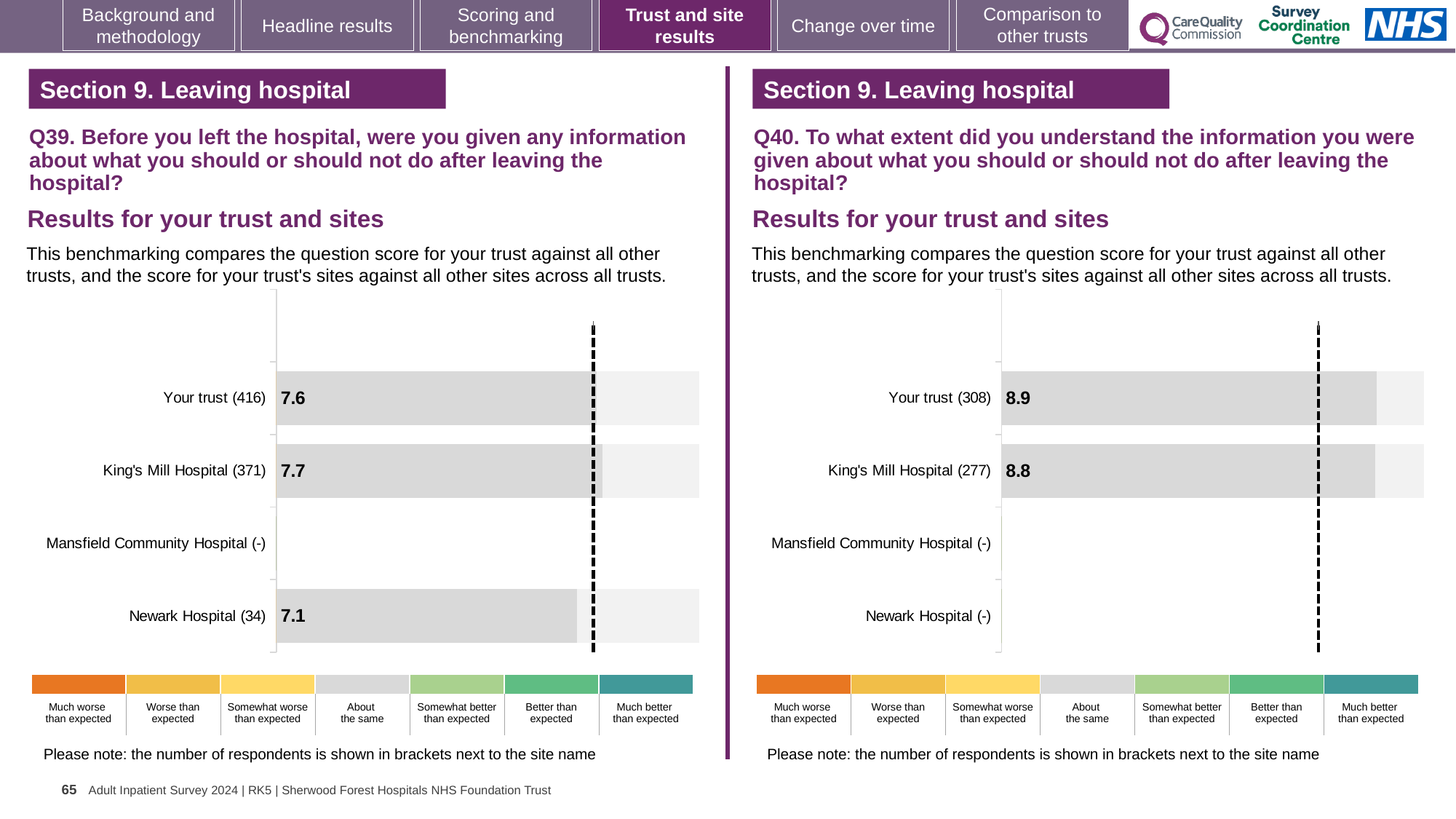
In the Q39 chart on the left, what is the difference between the King's Mill Hospital score and the Newark Hospital score? 0.6 In the Q39 chart on the left, what is the score for Newark Hospital? 7.1 In the Q40 chart on the right, how many respondents are shown for Your trust? 308 In the Q39 chart on the left, what is the score for King's Mill Hospital? 7.7 How many site rows (including Your trust) are listed in the Q40 chart on the right? 4 In the Q40 chart on the right, what is the score for King's Mill Hospital? 8.8 In the Q39 chart on the left, how many respondents are shown for Newark Hospital? 34 In the Q39 chart on the left, which site has the lowest score? Newark Hospital In the Q39 chart on the left, what is the score for Your trust? 7.6 What kind of chart is used in the Q39 chart on the left? Bar chart In the Q40 chart on the right, what is the difference between the Your trust score and the King's Mill Hospital score? 0.1 In the Q40 chart on the right, what is the score for Your trust? 8.9